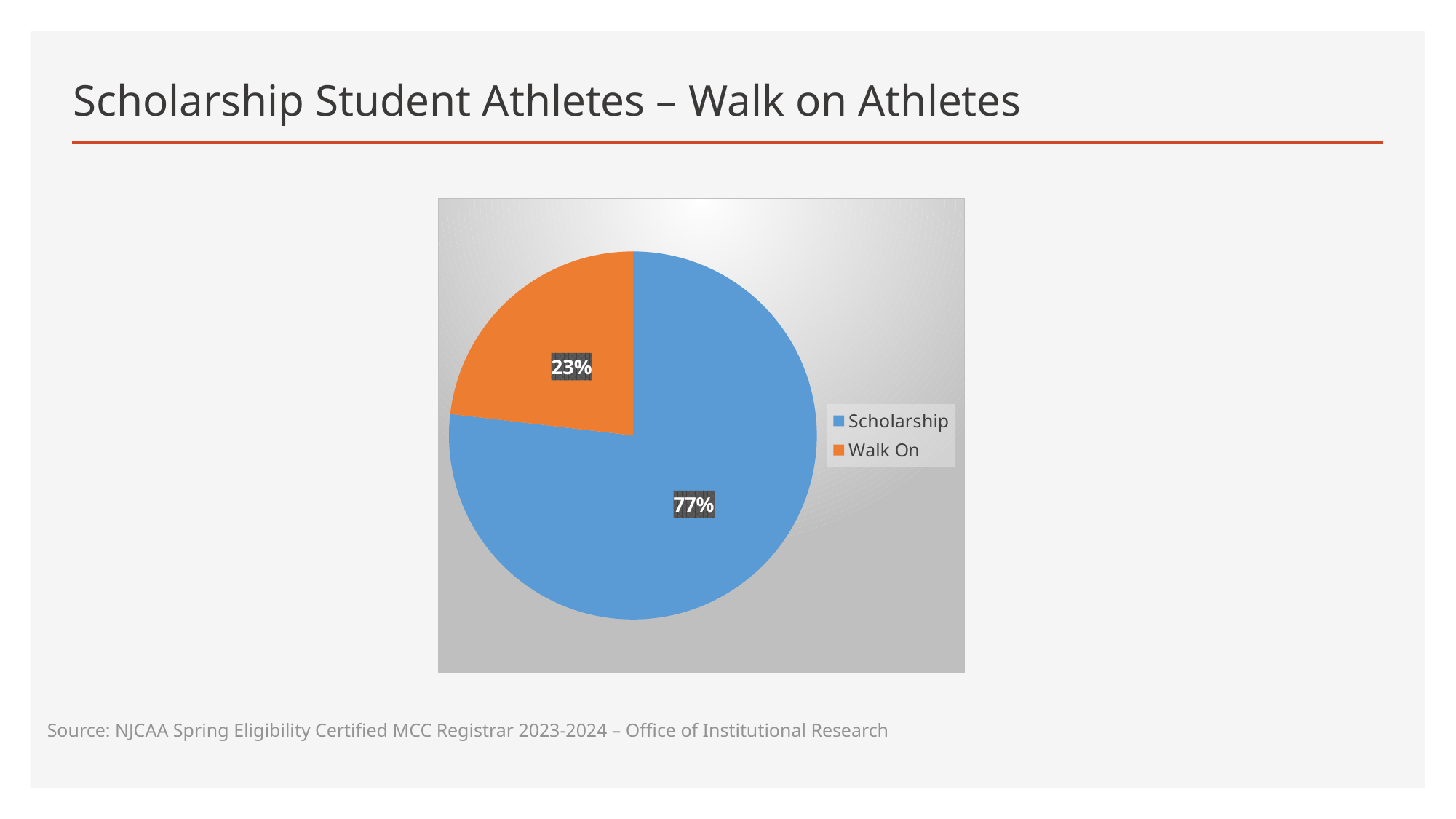
What is the difference in percentage points between the Scholarship and Walk On slices? 54 What share of the pie is Walk On? 23% Which category has the largest slice of the pie? Scholarship How many categories does the pie chart show? 2 How many entries does the legend list? 2 What share of the pie is Scholarship? 77% Which category has the smallest slice of the pie? Walk On Which is larger, the Scholarship slice or the Walk On slice? Scholarship What colour is the Walk On slice? orange What kind of chart is shown on the slide? pie chart What is the total of the two slice percentages shown? 100% What colour is the Scholarship slice? blue